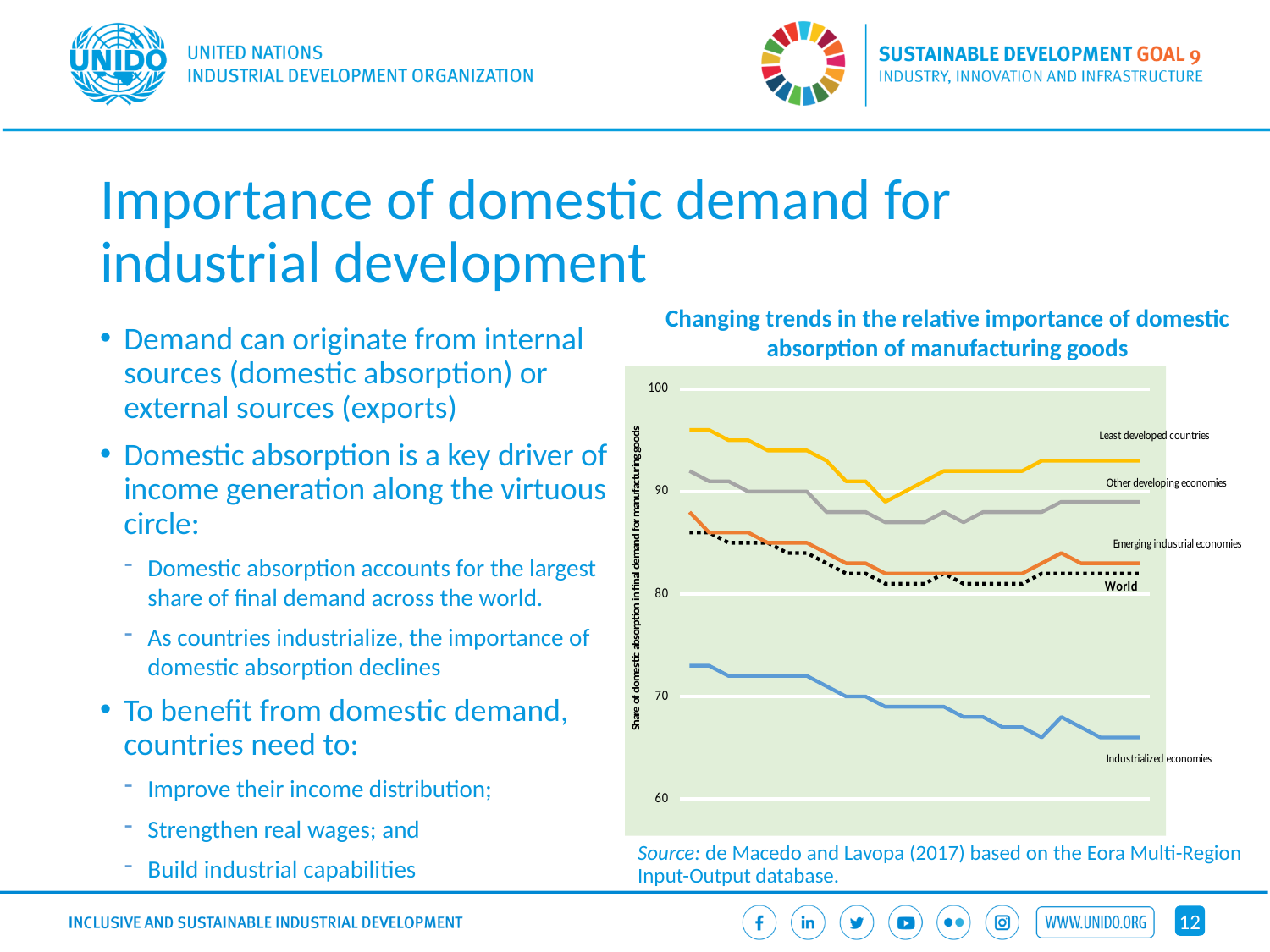
Are the values for Industrialized economies greater or less than 80 across the whole chart? less What kind of chart is shown on the slide? Line chart Which series is drawn as a dotted black line? World Which series has the lowest values throughout the chart? Industrialized economies What is the title of the chart? Changing trends in the relative importance of domestic absorption of manufacturing goods Are the values for Least developed countries greater or less than 80 across the whole chart? greater Which series is higher at the end of the chart, Other developing economies or Emerging industrial economies? Other developing economies Which series has the highest values throughout the chart? Least developed countries Do the values for Industrialized economies rise or fall along the x axis? Fall Is the value for Industrialized economies at the end of the series greater or less than 70? less How many series are plotted in the chart? 5